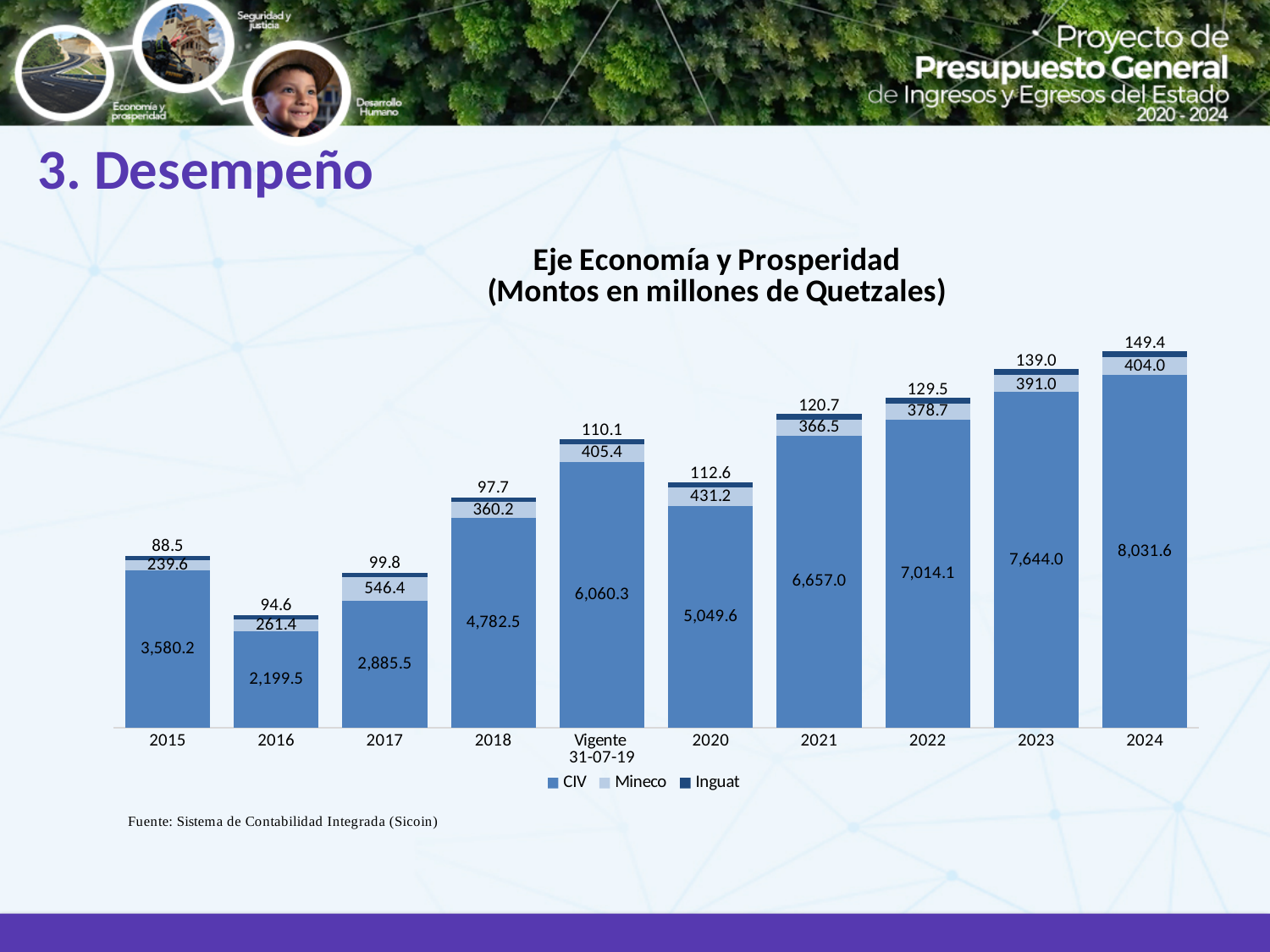
What is the total of the stacked bar for 2024? 8,585.0 Which category has the highest Mineco value? 2017 Which year has the lowest CIV value? 2016 What is the Inguat value for 2020? 112.6 What is the CIV value for 2024? 8,031.6 What is the CIV value for Vigente 31-07-19? 6,060.3 Which category has the lowest Inguat value? 2015 What is the difference between the CIV values for 2024 and 2023? 387.6 How many series does the legend list? 3 How many categories are shown on the x axis? 10 Is the CIV value for 2021 larger than the CIV value for 2020? Yes What is the Mineco value for 2017? 546.4